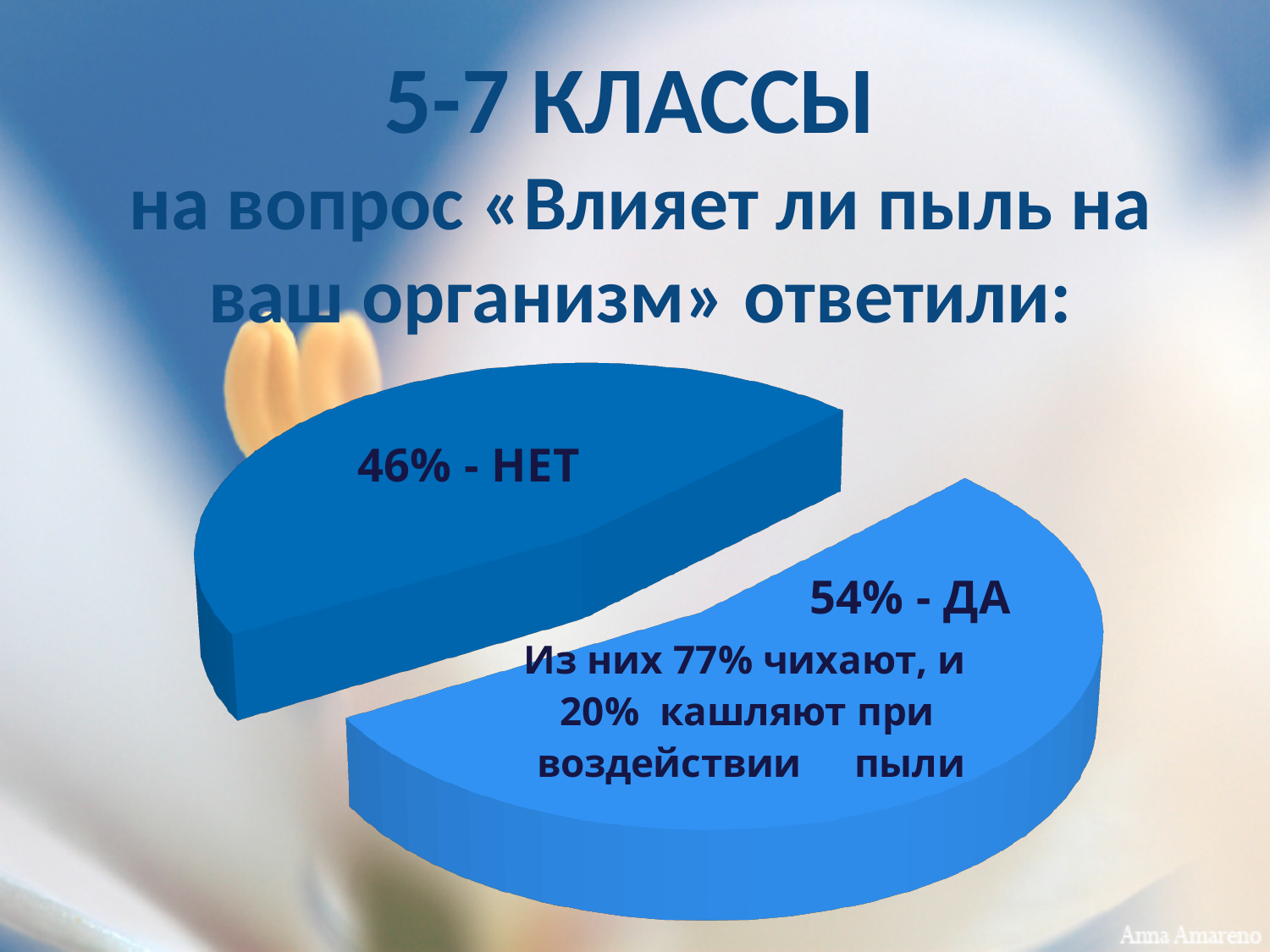
What kind of chart is shown on the slide? pie chart Is the share for «НЕТ» greater or less than 50%? less What share of the pie is labelled «ДА»? 54% According to the text on the «ДА» slice, what percentage of those who answered «ДА» sneeze when exposed to dust? 77% Which grades (классы) does the chart title say the survey covers? 5-7 классы What share of the pie is labelled «НЕТ»? 46% Which answer has the largest slice in the pie chart? ДА How many slices does the pie chart have? 2 Which answer has the smallest slice in the pie chart? НЕТ What is the difference in percentage points between the «ДА» and «НЕТ» slices? 8 According to the text on the «ДА» slice, what percentage of those who answered «ДА» cough when exposed to dust? 20% Which answer has the larger slice, «ДА» or «НЕТ»? ДА